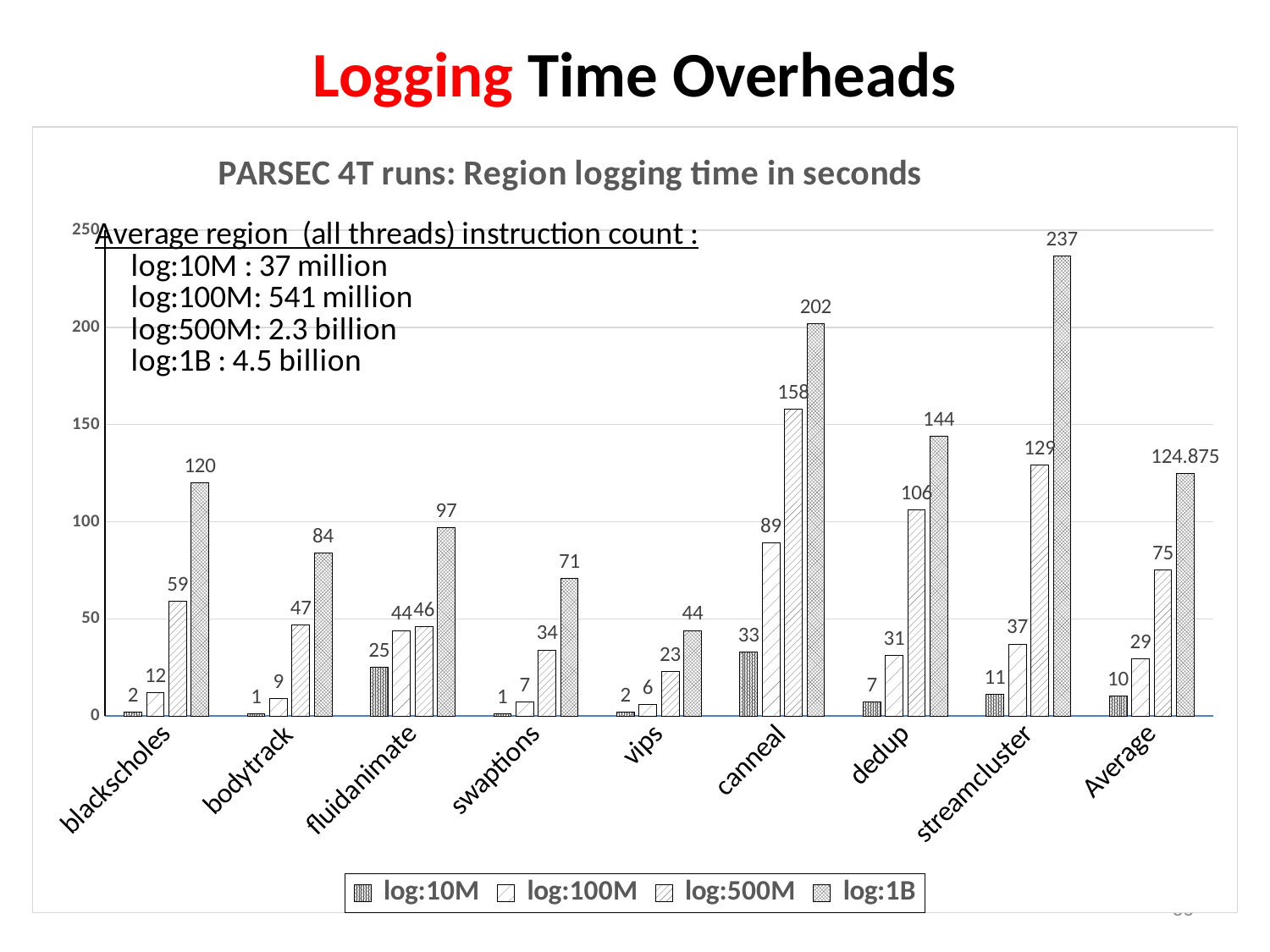
What is the log:1B value for streamcluster? 237 What is the log:1B value for the Average category? 124.875 Which category has the lowest log:500M value? vips What is the difference between the log:1B and log:500M values for dedup? 38 How many categories are shown on the x axis? 9 What is the log:500M value for canneal? 158 What kind of chart is shown on the slide? bar chart Which is larger, the log:1B value for canneal or the log:1B value for streamcluster? streamcluster What is the log:10M value for fluidanimate? 25 How many series does the legend list? 4 What is the title of the chart? PARSEC 4T runs: Region logging time in seconds Which category has the highest log:1B value? streamcluster